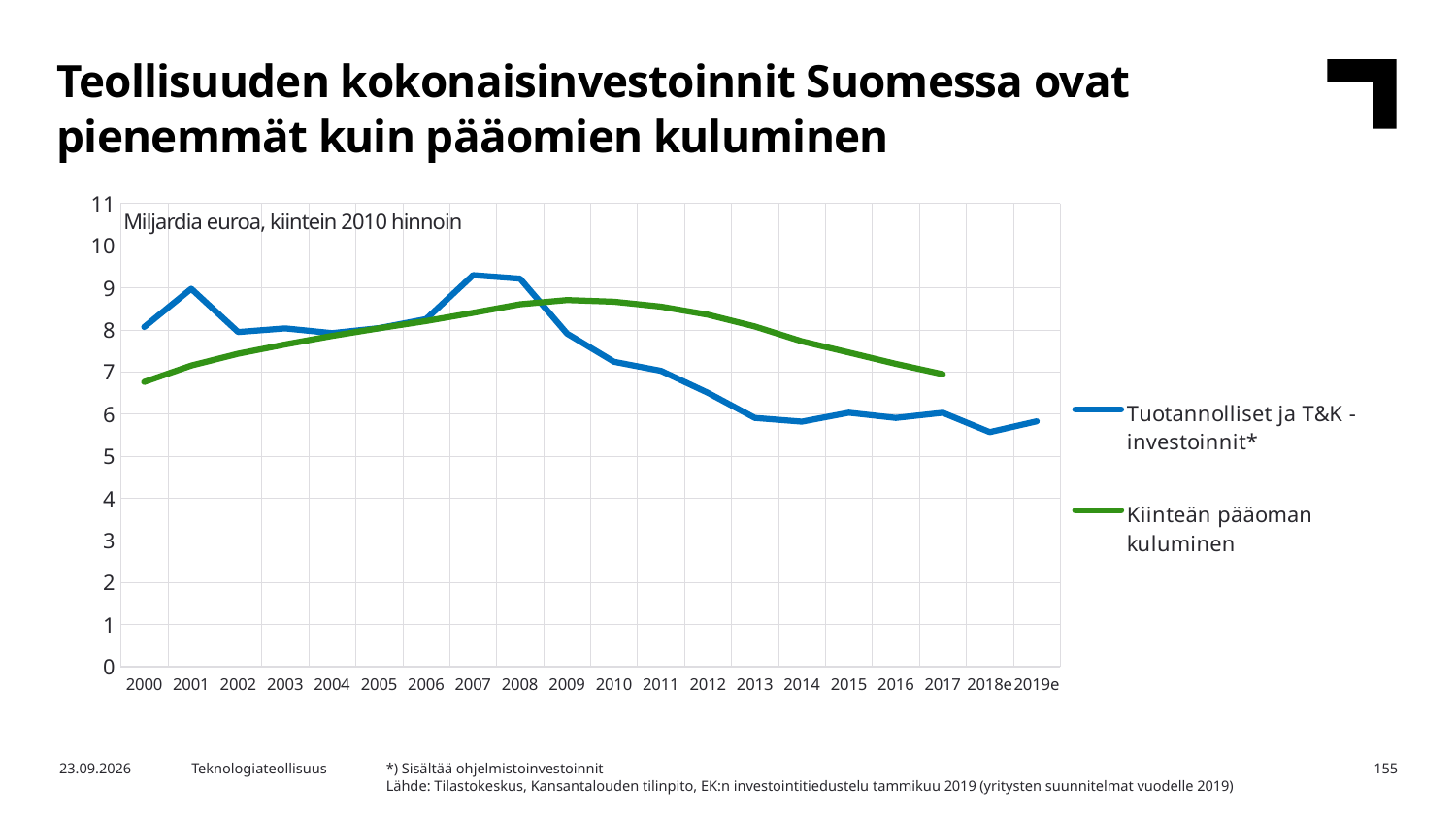
What unit label is shown inside the chart area? Miljardia euroa, kiintein 2010 hinnoin How many series does the legend list? 2 In which year is the Kiinteän pääoman kuluminen series at its lowest? 2000 How many years are shown on the x axis? 20 In which year is the Tuotannolliset ja T&K -investoinnit* series at its lowest? 2018e Is the value for Tuotannolliset ja T&K -investoinnit* in 2007 greater or less than 9? greater Is the value for Tuotannolliset ja T&K -investoinnit* in 2018e greater or less than 6? less Is the value for Kiinteän pääoman kuluminen in 2009 greater or less than 8? greater In which year does the Tuotannolliset ja T&K -investoinnit* series reach its highest value? 2007 Does the Kiinteän pääoman kuluminen series rise or fall between 2009 and 2017? fall What kind of chart is shown on the slide? line chart In 2012, which series has the higher value: Tuotannolliset ja T&K -investoinnit* or Kiinteän pääoman kuluminen? Kiinteän pääoman kuluminen